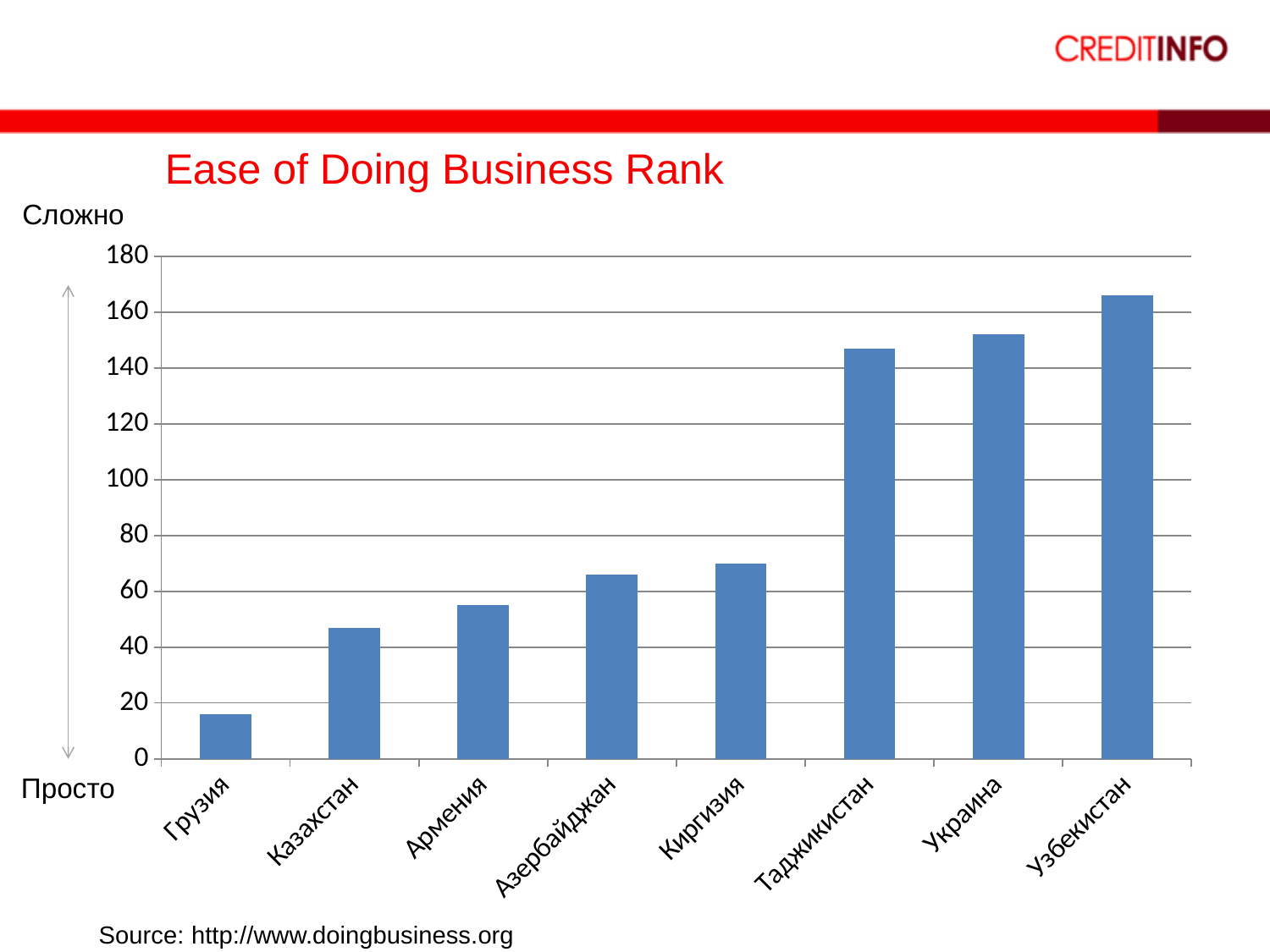
Do the bar values rise or fall from left to right along the x axis? rise Which country has the highest bar in the chart? Узбекистан Which has the larger value, Армения or Украина? Украина Is the value for Казахстан greater or less than 40? greater What is the title of the chart? Ease of Doing Business Rank Which country has the lowest bar in the chart? Грузия How many countries are shown on the x axis of the chart? 8 Is the value for Таджикистан greater or less than 140? greater Is the value for Узбекистан greater or less than 160? greater What source is cited below the chart? http://www.doingbusiness.org What kind of chart is shown on the slide? bar chart